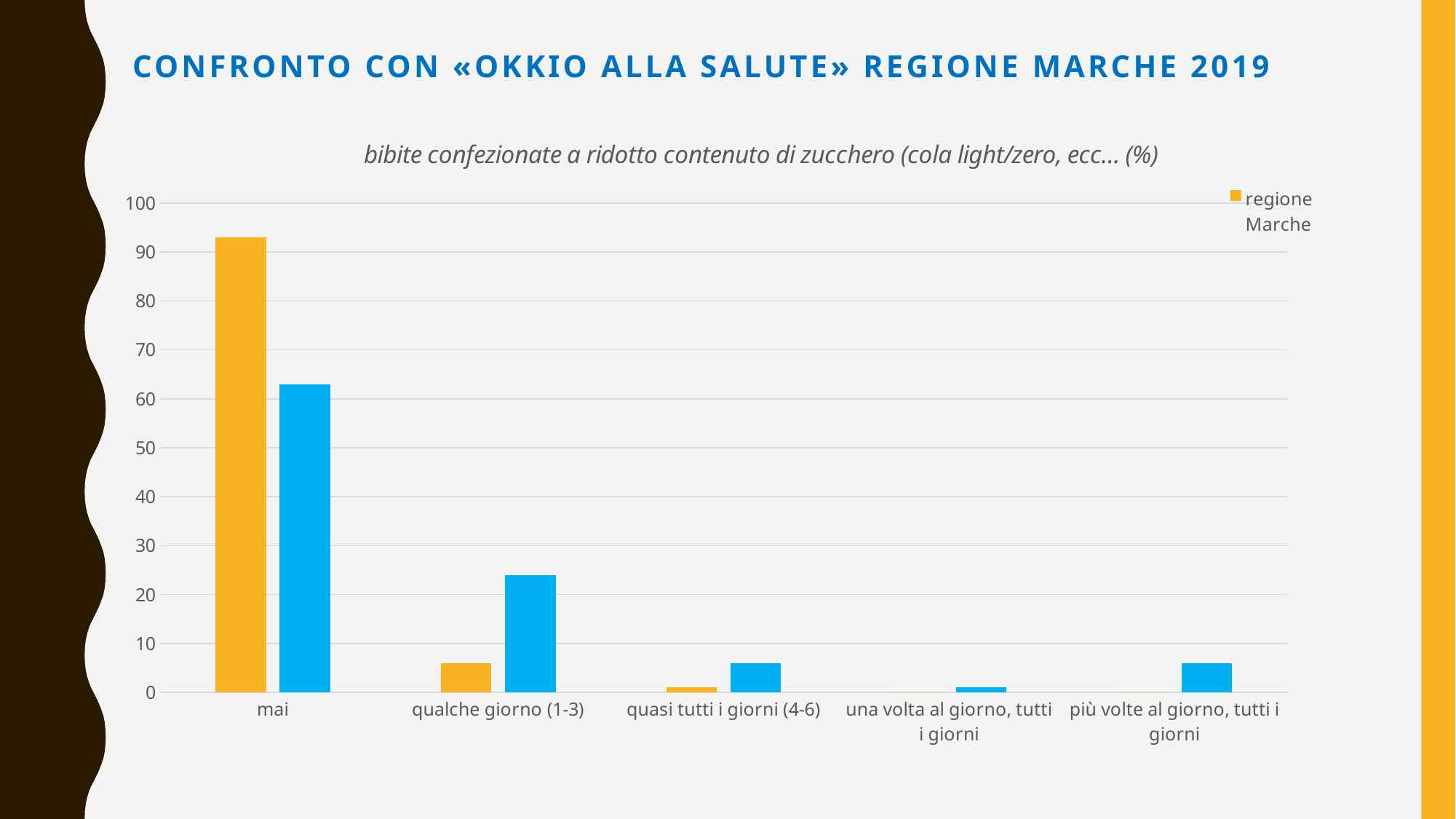
Which series is named in the chart's legend? regione Marche For the 'regione Marche' series, which category has the highest value? mai Is the blue bar for 'qualche giorno (1-3)' greater or less than 20? greater What kind of chart is shown on the slide? bar chart Is the blue bar for 'mai' greater or less than 60? greater What colour are the bars for the 'regione Marche' series? yellow For the category 'mai', which bar is larger: the yellow 'regione Marche' bar or the blue bar? the yellow 'regione Marche' bar Is the 'regione Marche' value for 'qualche giorno (1-3)' greater or less than 10? less How many categories are shown on the x axis of the chart? 5 How many series does the chart's legend list? 1 Do the 'regione Marche' values rise or fall moving from 'mai' to 'più volte al giorno, tutti i giorni' along the x axis? fall